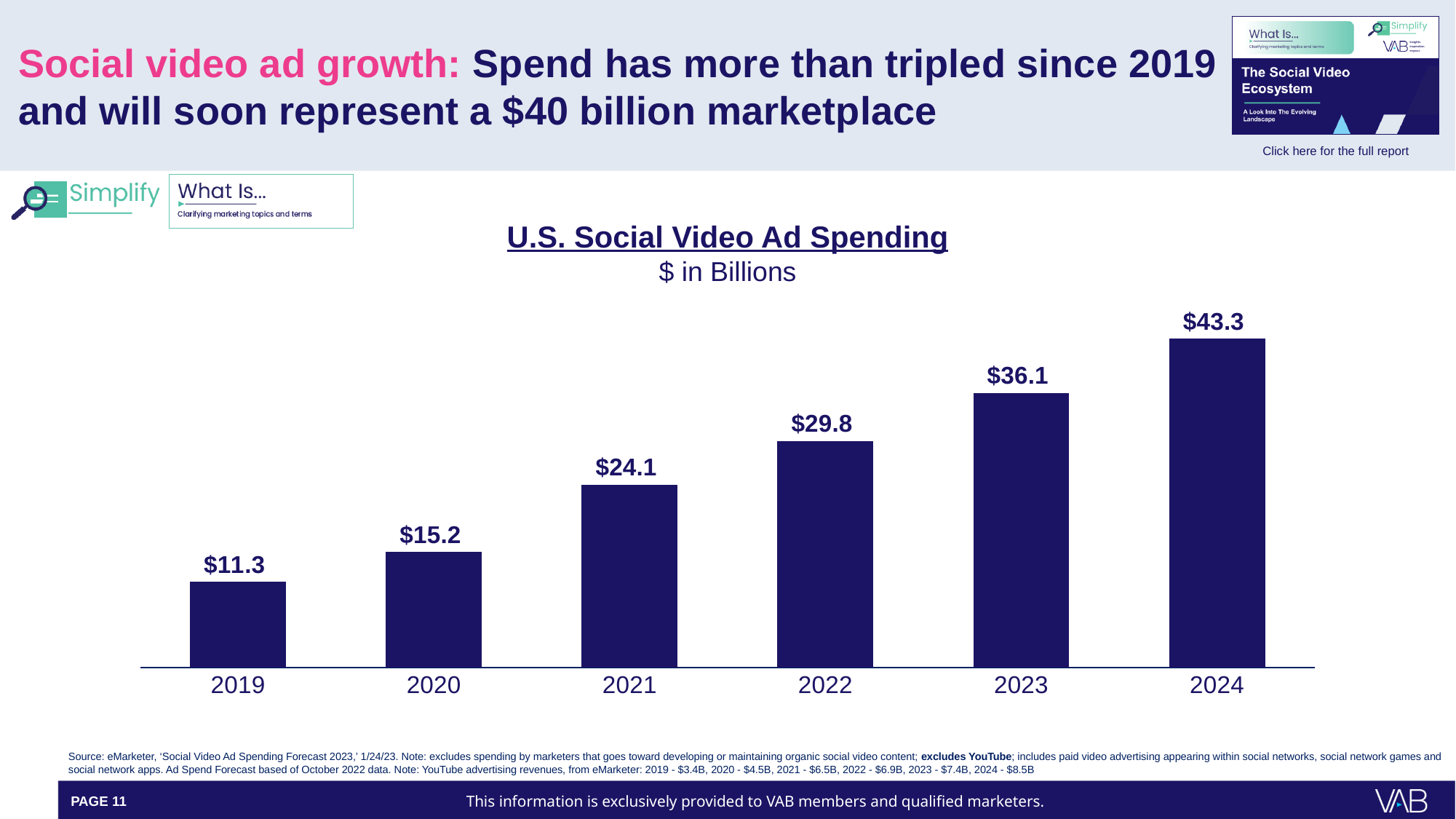
Which year has the highest value? 2024 Which year has the lowest value? 2019 What is the title of the chart? U.S. Social Video Ad Spending What is the value shown for 2022? $29.8 How many years are shown on the x axis? 6 What is the value shown for 2024? $43.3 Do the values rise or fall from 2019 to 2024? Rise What is the U.S. social video ad spending value shown for 2019? $11.3 Which is larger, the value for 2023 or the value for 2022? 2023 What is the difference between the 2021 value and the 2020 value? $8.9 What kind of chart is shown? Bar chart What is the difference between the 2024 value and the 2019 value? $32.0